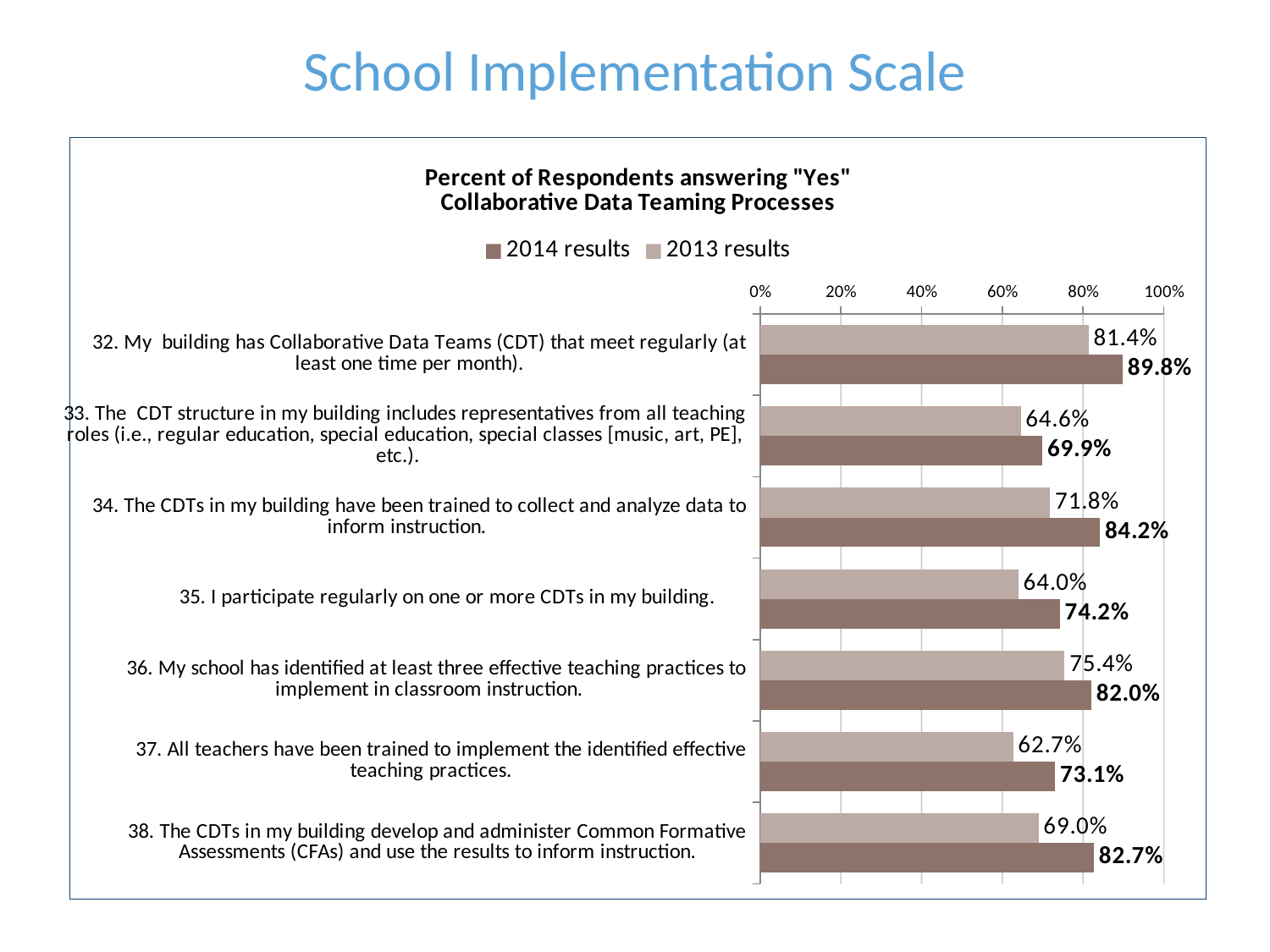
Which item has the lowest 2013 result? 37. All teachers have been trained to implement the identified effective teaching practices. What is the 2014 result for item 32 (My building has Collaborative Data Teams that meet regularly)? 89.8% Is the 2013 result for item 33 greater or less than 60%? greater Which item has the highest 2014 result? 32. My building has Collaborative Data Teams (CDT) that meet regularly (at least one time per month). What is the difference between the 2014 and 2013 results for item 34? 12.4% Which is larger: the 2014 result for item 36 or the 2014 result for item 37? 2014 result for item 36 What is the difference between the 2014 and 2013 results for item 38? 13.7% How many series does the legend list? 2 How many survey items are shown in the chart? 7 What kind of chart is shown on the slide? bar chart What is the 2013 result for item 38 (The CDTs in my building develop and administer Common Formative Assessments)? 69.0% What is the 2013 result for item 35 (I participate regularly on one or more CDTs in my building)? 64.0%